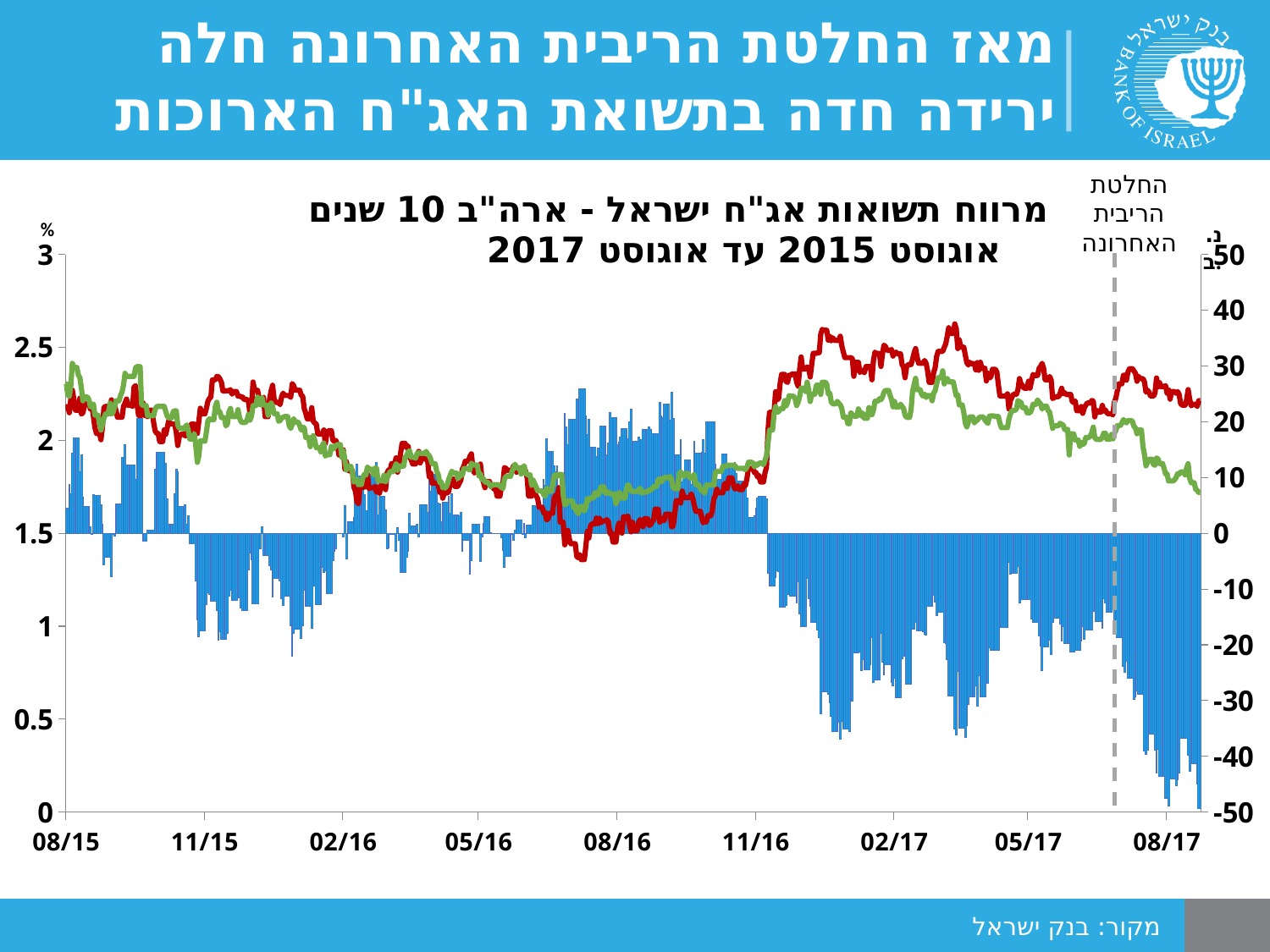
Is the value of the green line at 08/17 greater or less than 2 on the left axis? less Is the value of the red line at 02/17 greater or less than 2 on the left axis? greater How many date labels are shown on the x axis? 9 Is the value of the red line at 08/17 greater or less than 2 on the left axis? greater Which line is higher at 02/17, the red line or the green line? the red line How many line series are plotted on the chart? 2 What kind of chart is shown on the slide? A combined line and bar chart Does the red line rise or fall between 08/16 and 11/16? rise Does the green line rise or fall between 05/17 and 08/17? fall What is the range of the right vertical axis? -50 to 50 What is the range of the left vertical axis? 0 to 3